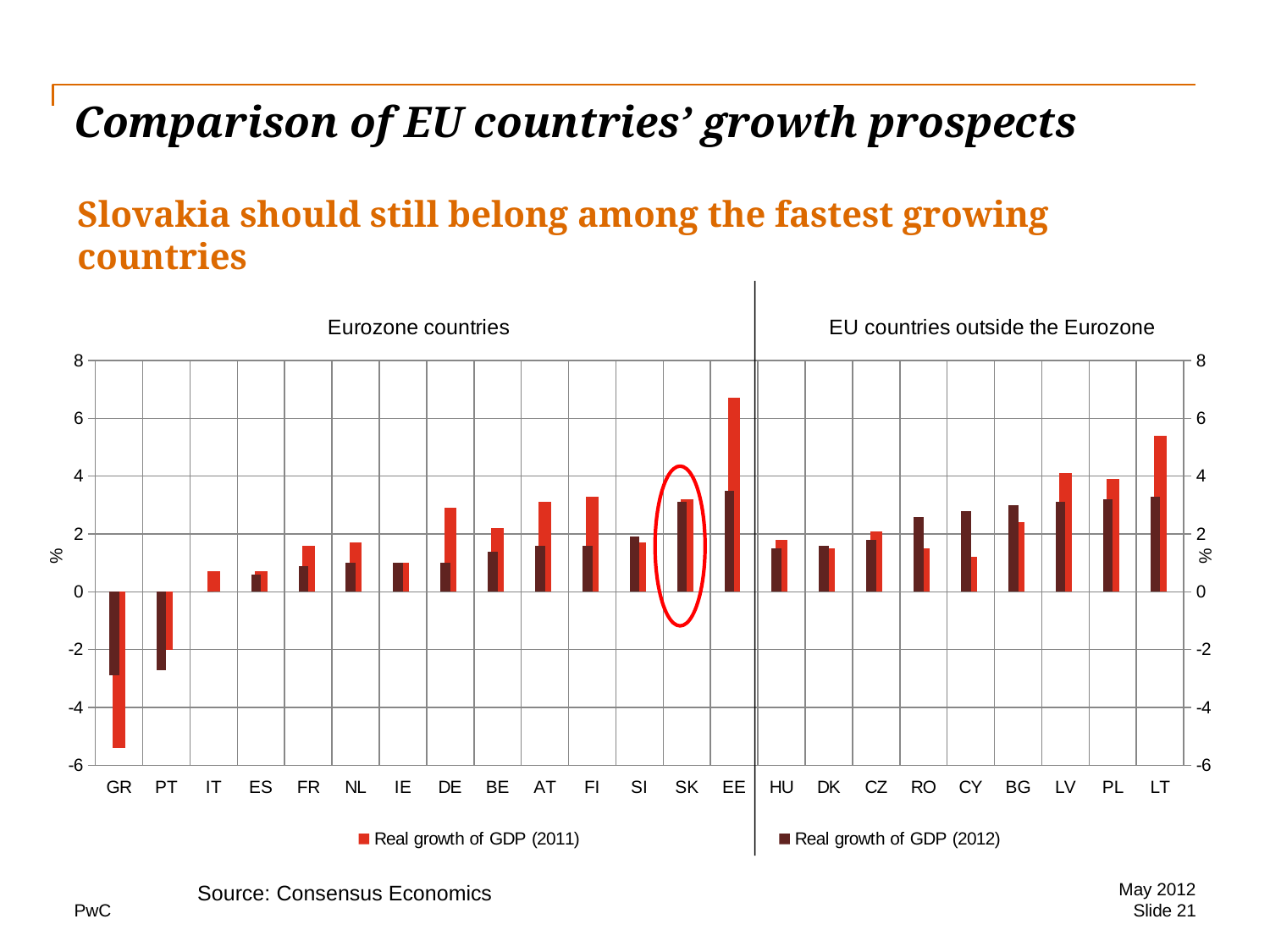
Which is larger for DE: Real growth of GDP (2011) or Real growth of GDP (2012)? Real growth of GDP (2011) Which country's bars are circled in red on the chart? SK How many series does the legend list? 2 What kind of chart is shown on the slide? bar chart Which country has the lowest Real growth of GDP (2011)? GR How many countries are shown on the x axis of the chart? 23 Is the Real growth of GDP (2011) for GR greater or less than -4? less Is the Real growth of GDP (2011) for EE greater or less than 6? greater Is the Real growth of GDP (2011) for IT greater or less than 2? less How many countries are shown in the 'Eurozone countries' section of the chart? 14 Which country has the highest Real growth of GDP (2011)? EE